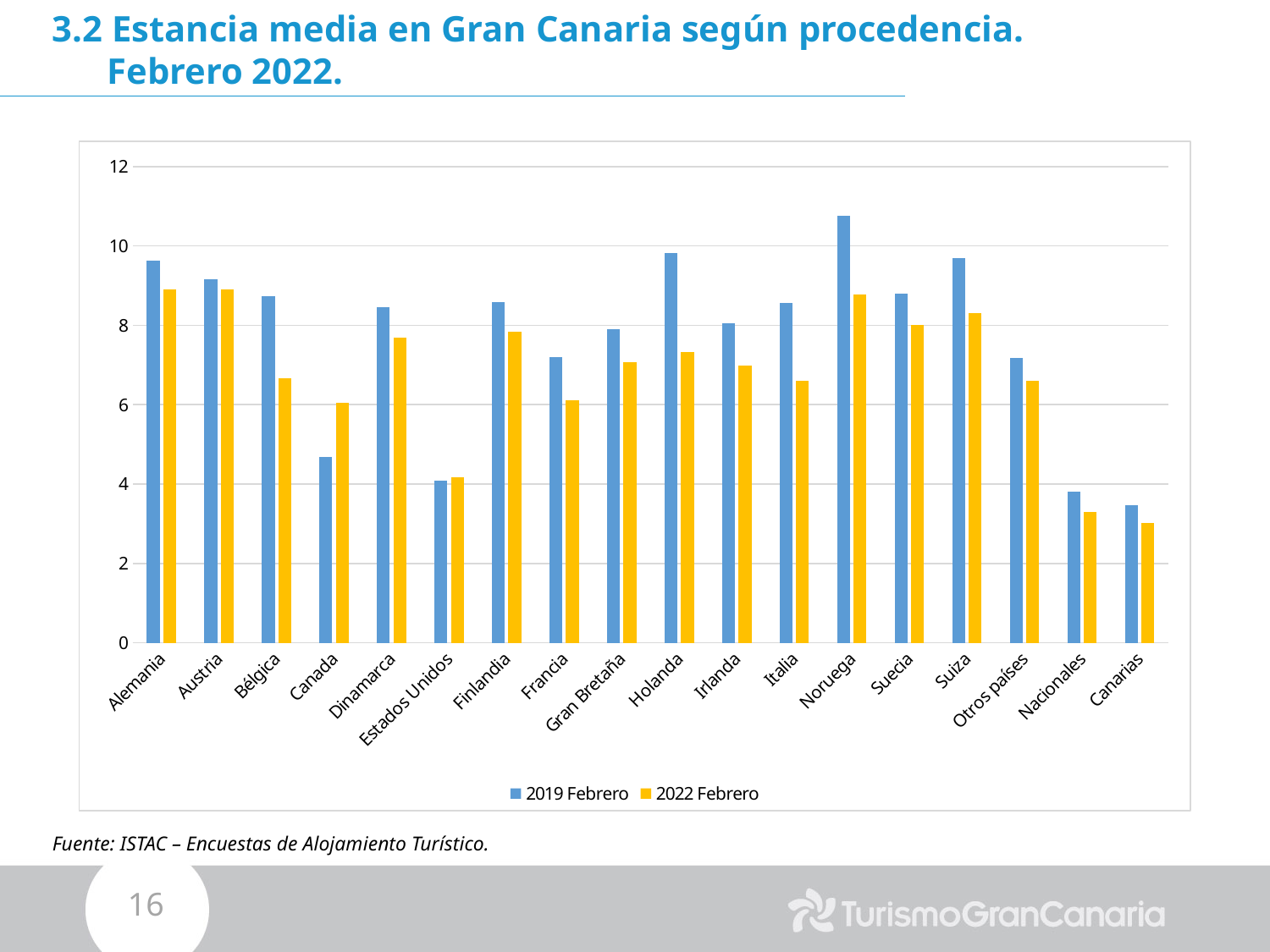
Which has the larger 2019 Febrero value, Holanda or Irlanda? Holanda For Canadá, which series has the larger value, 2019 Febrero or 2022 Febrero? 2022 Febrero What are the two entries listed in the legend? 2019 Febrero and 2022 Febrero How many series does the legend list? 2 Which category has the lowest value for 2019 Febrero? Canarias Is the 2022 Febrero value for Suiza greater or less than 8? greater Is the 2019 Febrero value for Noruega greater or less than 10? greater Which category has the highest value for 2019 Febrero? Noruega How many origin categories are shown on the x axis? 18 What kind of chart is shown on the slide? bar chart Is the 2019 Febrero value for Canadá greater or less than 6? less